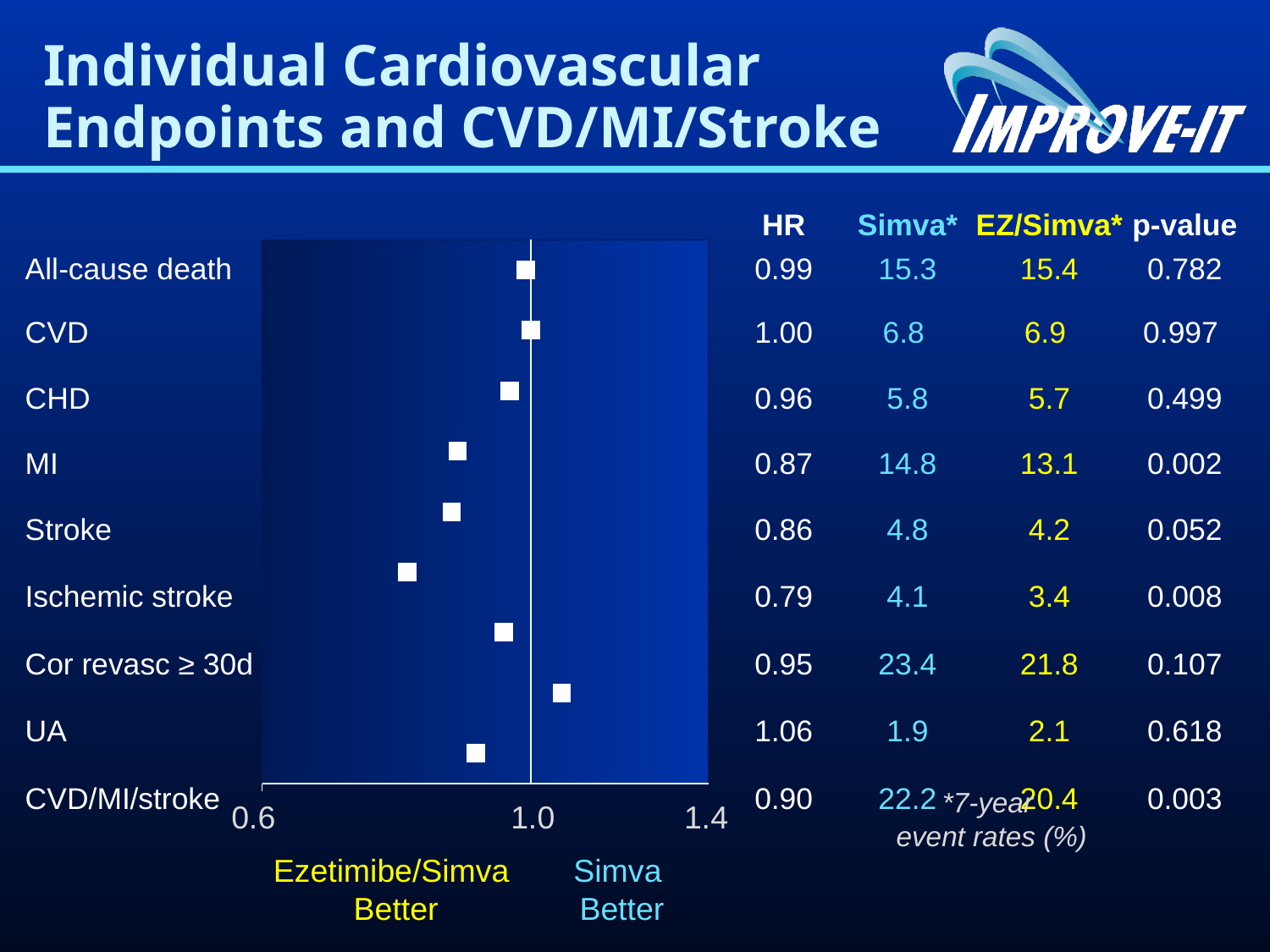
What is the hazard ratio (HR) plotted for MI? 0.87 Which has the larger hazard ratio, UA or Stroke? UA What kind of chart is used to display the hazard ratios? scatter chart What is the difference between the hazard ratio for UA and the hazard ratio for Ischemic stroke? 0.27 How many endpoints are plotted on the chart? 9 Is the hazard ratio for Ischemic stroke greater or less than 1.0? less Is the hazard ratio for UA greater or less than 1.0? greater What is the hazard ratio (HR) plotted for CVD/MI/stroke? 0.90 What is the hazard ratio (HR) plotted for Ischemic stroke? 0.79 Which endpoint has the highest hazard ratio on the chart? UA What are the minimum and maximum values shown on the chart's x axis? 0.6 and 1.4 Which endpoint has the lowest hazard ratio on the chart? Ischemic stroke